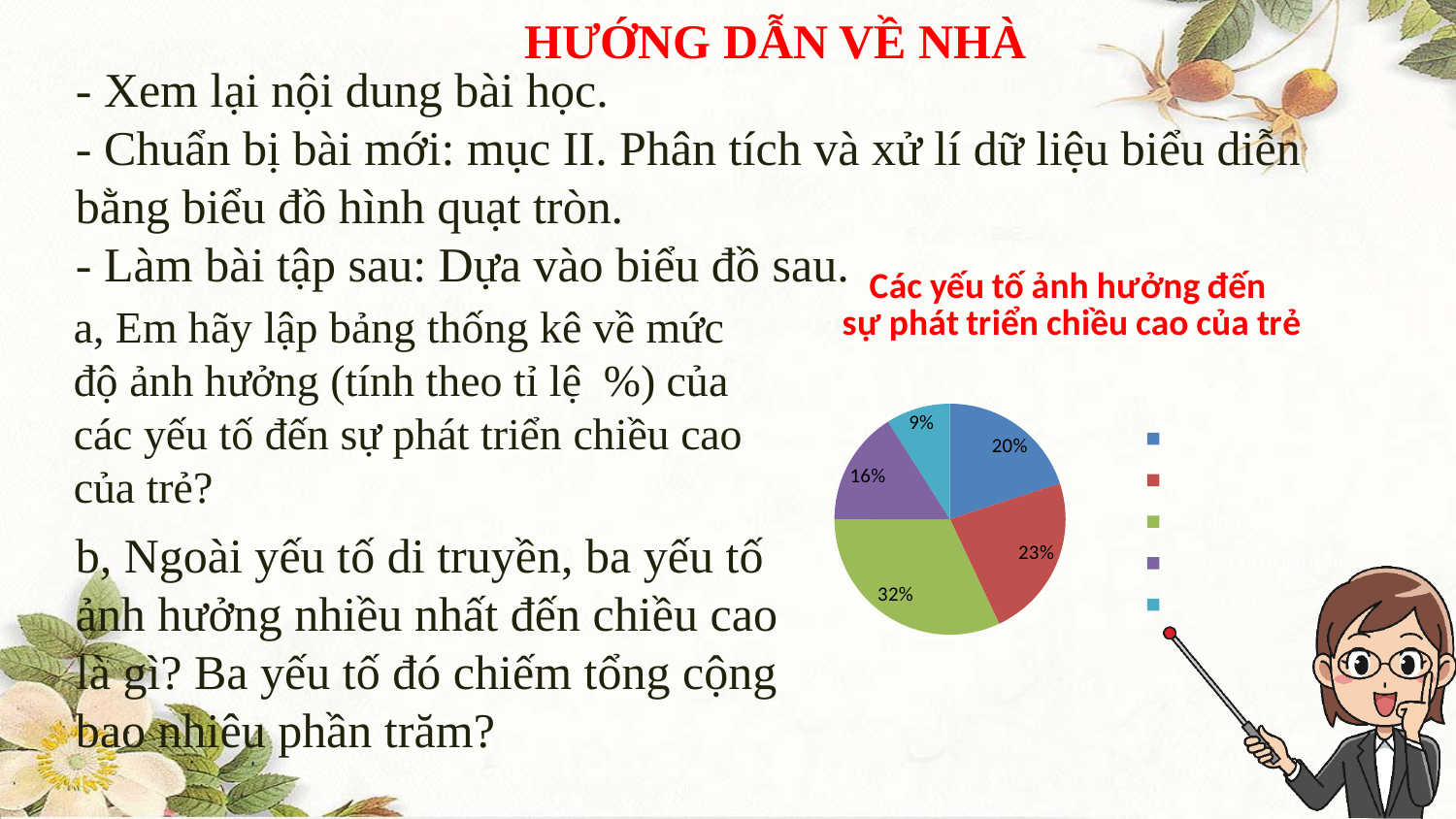
How many slices does the pie chart have? 5 What is the largest percentage shown on the pie chart? 32% How many entries does the legend of the pie chart list? 5 Which slice is larger, the blue slice or the purple slice? the blue slice (20%) What is the smallest percentage shown on the pie chart? 9% What is the title of the pie chart? Các yếu tố ảnh hưởng đến sự phát triển chiều cao của trẻ What percentage is shown on the blue slice of the pie chart? 20% What percentage is shown on the purple slice of the pie chart? 16% What is the combined share of the three largest slices (32%, 23% and 20%)? 75% What is the difference between the green slice (32%) and the red slice (23%)? 9% What kind of chart is shown on the slide? pie chart What percentage is shown on the red slice of the pie chart? 23%